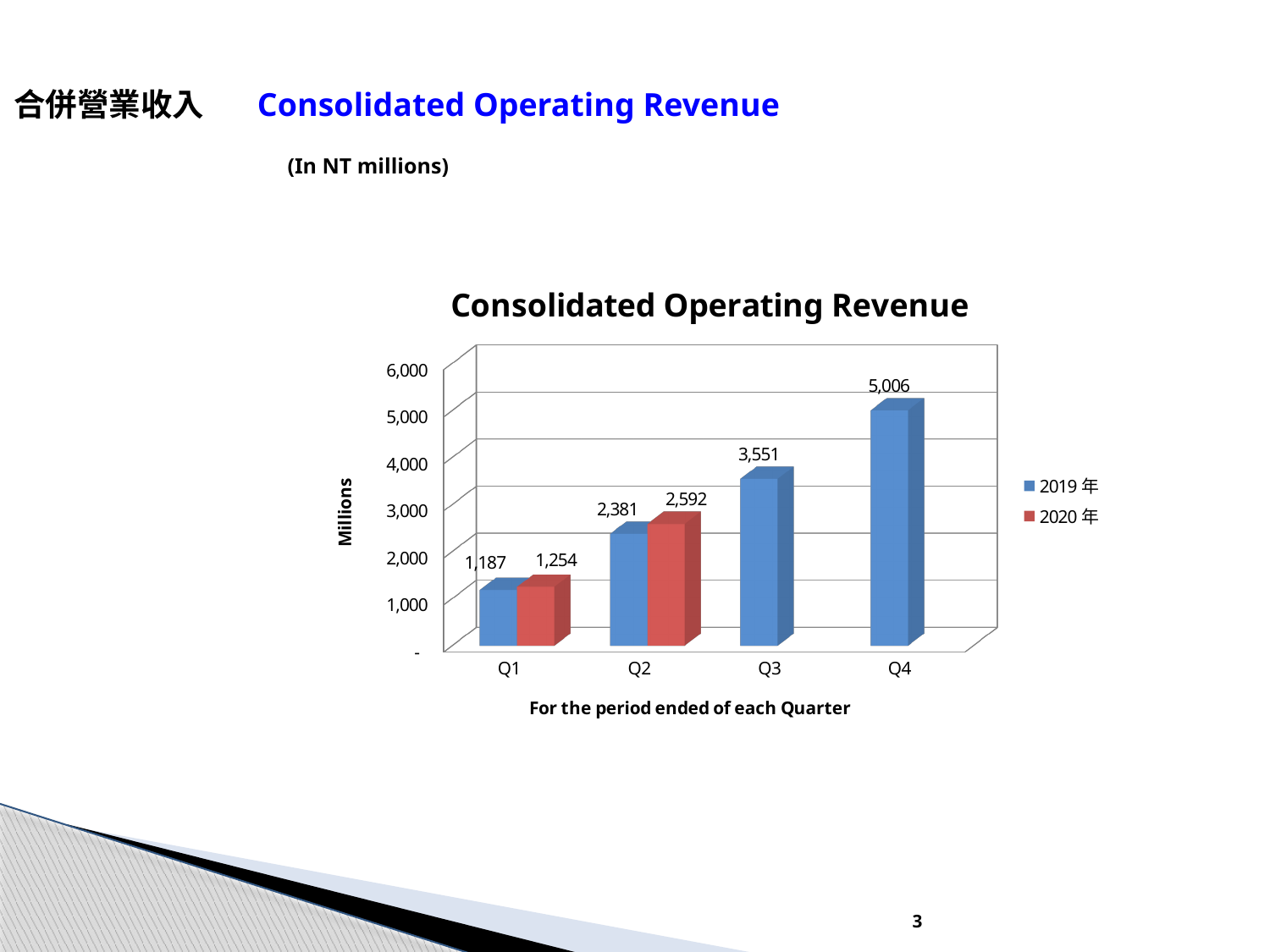
Is the 2019 年 value for Q3 greater or less than 3,000? greater Which is larger for Q1, the 2019 年 value or the 2020 年 value? 2020 年 What is the 2019 年 value for Q1? 1,187 What is the difference between the 2020 年 and 2019 年 values for Q2? 211 How many quarters are shown on the x axis? 4 What kind of chart is shown? bar chart Which quarter has the lowest 2019 年 value? Q1 Do the 2019 年 values rise or fall from Q1 to Q4? rise How many series does the legend list? 2 What is the 2020 年 value for Q2? 2,592 What is the 2019 年 value for Q4? 5,006 Which quarter has the highest 2019 年 value? Q4